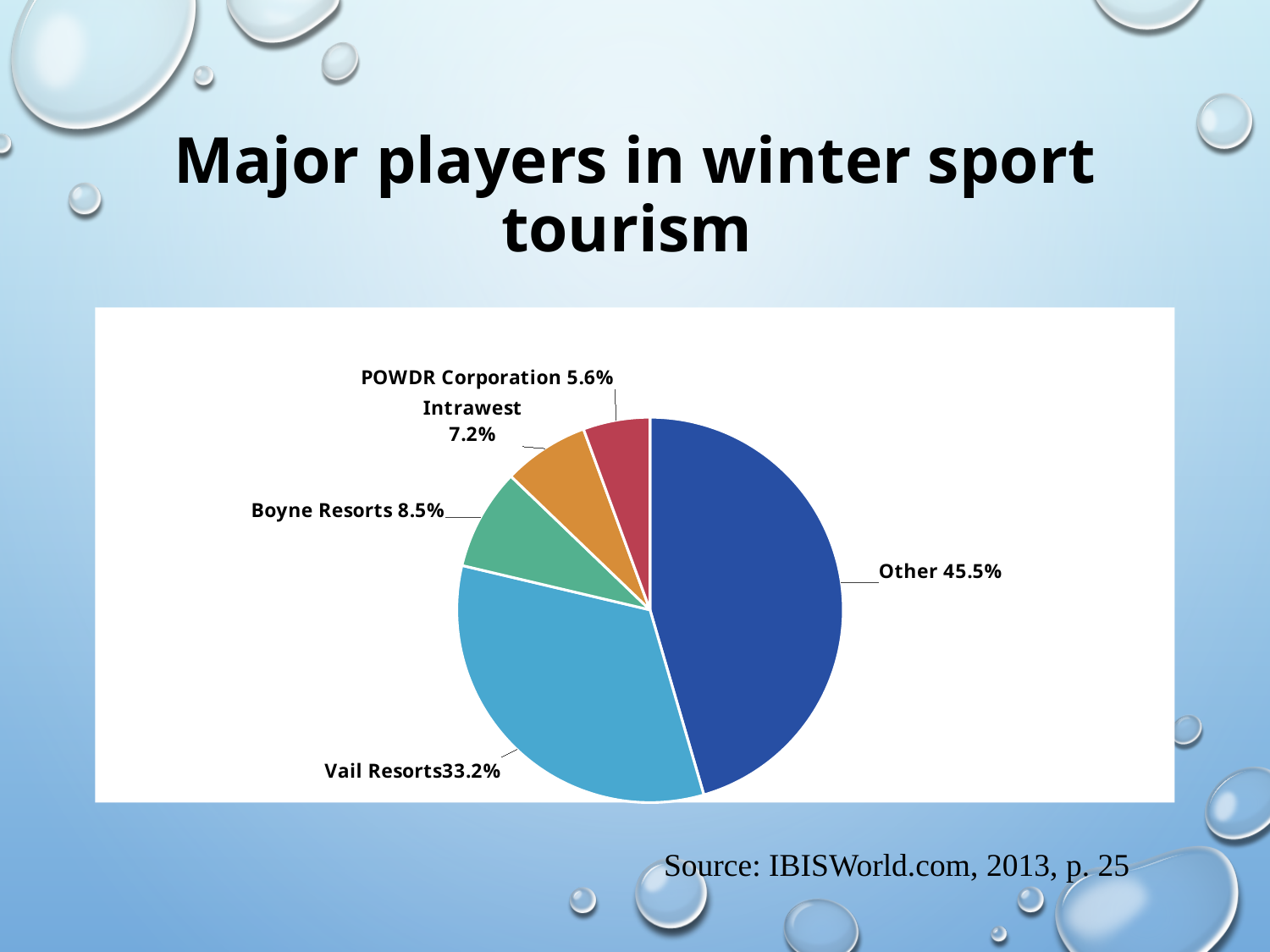
Which is larger, the share for Boyne Resorts or the share for Intrawest? Boyne Resorts What is the value shown for POWDR Corporation? 5.6% What kind of chart is shown on the slide? Pie chart What is the value shown for Boyne Resorts? 8.5% Which slice of the pie is the largest? Other What source is cited for the chart data? IBISWorld.com, 2013, p. 25 What is the title of the slide containing the pie chart? Major players in winter sport tourism What share of the pie does Vail Resorts hold? 33.2% What is the value shown for Intrawest? 7.2% How many slices does the pie chart have? 5 Which slice of the pie is the smallest? POWDR Corporation What is the difference between the Other share and the Vail Resorts share? 12.3%